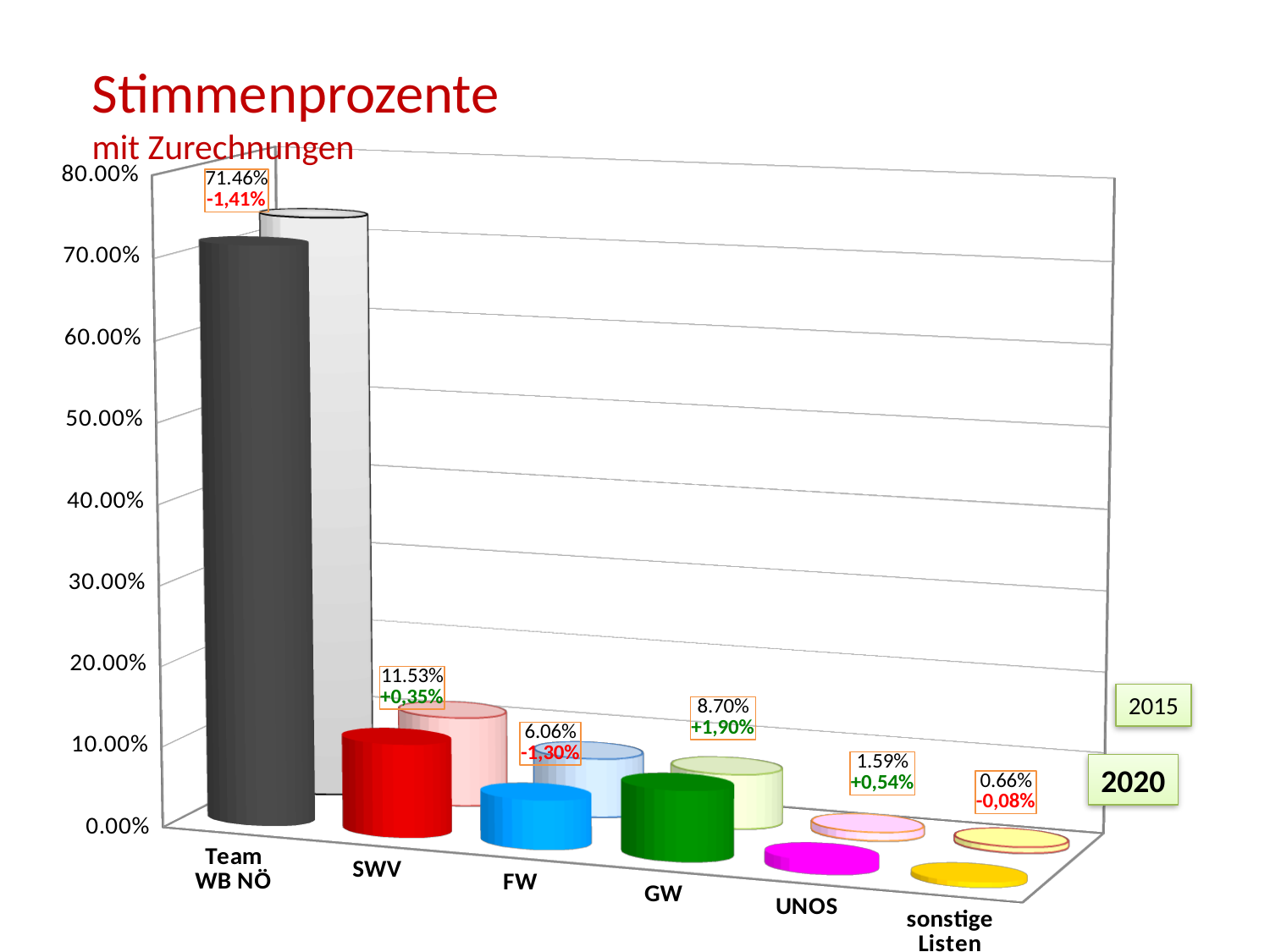
Is the 2015 value for Team WB NÖ greater or less than 70.00%? greater What is the 2020 value shown for UNOS? 1.59% How many categories are shown on the x axis? 6 What is the 2020 value shown for Team WB NÖ? 71.46% How many series does the legend list? 2 Which has a larger 2020 value, SWV or GW? SWV What kind of chart is shown on the slide? bar chart What change versus 2015 is shown for FW? -1,30% Which category has the lowest 2020 value? sonstige Listen What is the 2020 value shown for SWV? 11.53% Which category has the highest 2020 value? Team WB NÖ What is the 2020 value shown for GW? 8.70%